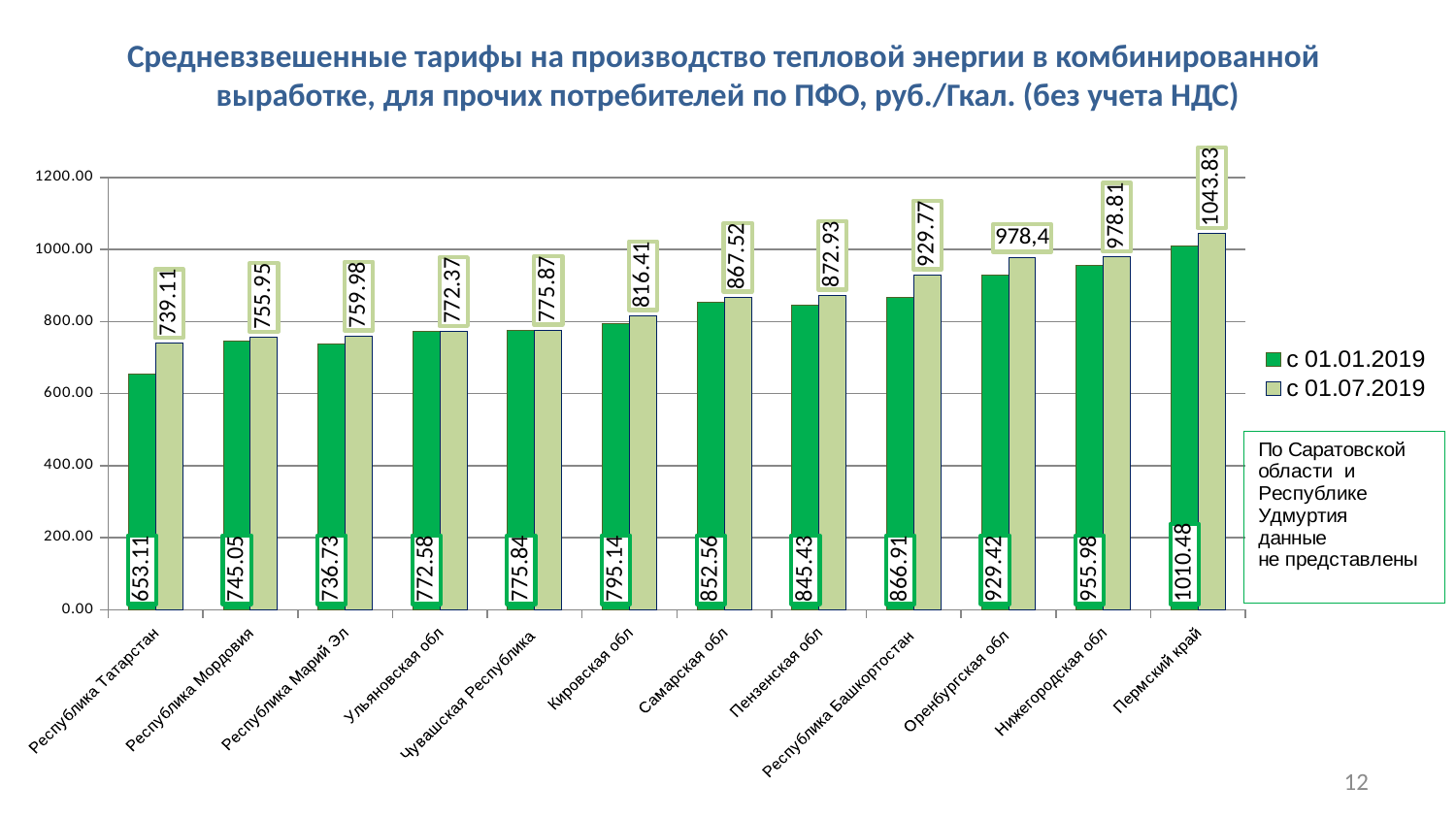
What is the difference between the с 01.07.2019 and с 01.01.2019 values for Кировская обл? 21.27 What is the value for Пермский край in the series с 01.07.2019? 1043.83 Which region has the highest value in the series с 01.07.2019? Пермский край Which region has the lowest value in the series с 01.01.2019? Республика Татарстан What is the value for Оренбургская обл in the series с 01.07.2019? 978,4 How many series does the legend list? 2 What kind of chart is shown on the slide? bar chart Which has the larger value in the series с 01.07.2019: Самарская обл or Пензенская обл? Пензенская обл What is the difference between the с 01.07.2019 and с 01.01.2019 values for Республика Татарстан? 86.00 How many regions are shown on the x axis? 12 Do the values in the series с 01.07.2019 generally rise or fall from left to right along the x axis? rise What is the value for Республика Татарстан in the series с 01.01.2019? 653.11